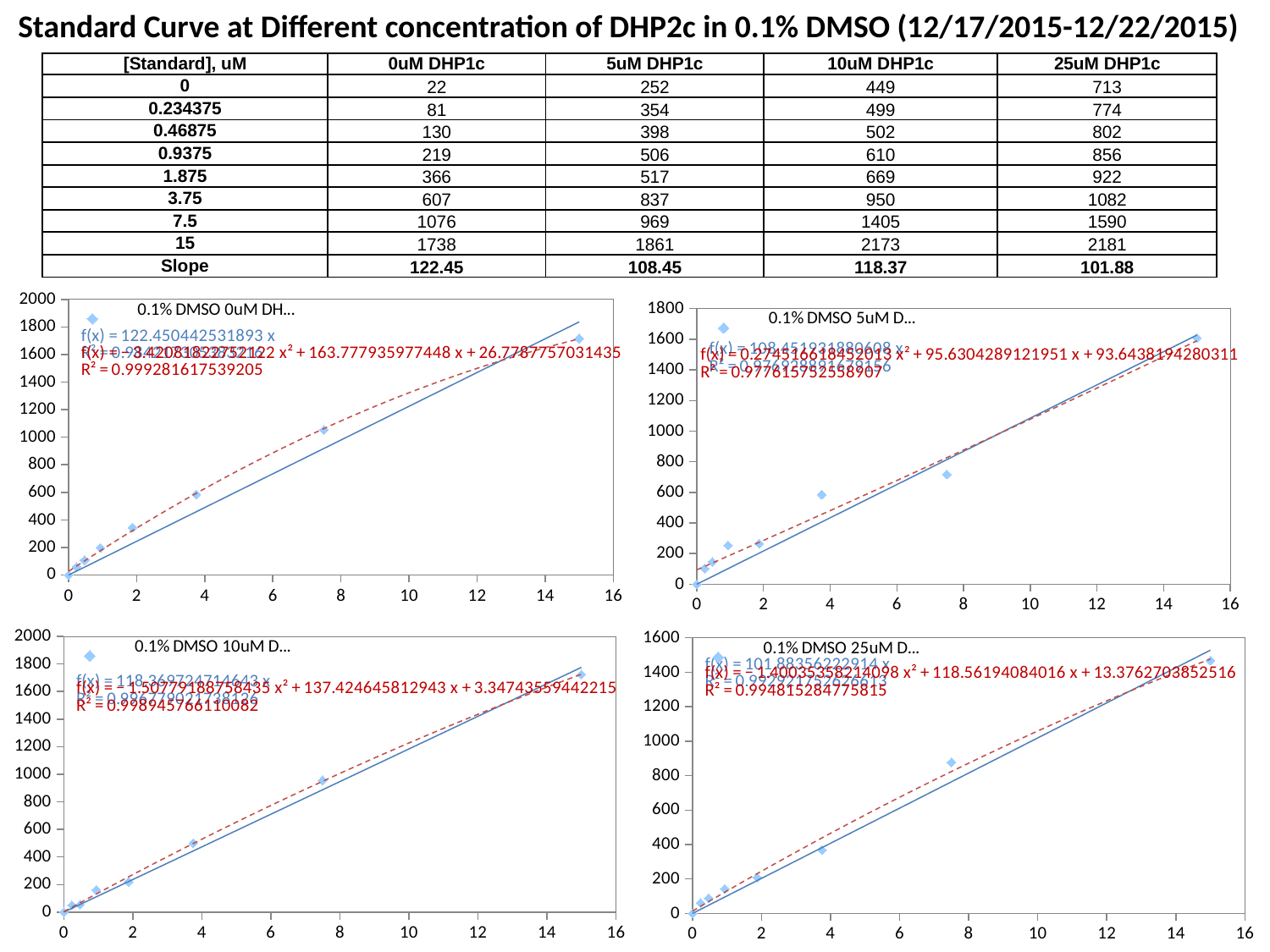
In the top-right chart (0.1% DMSO 5uM), is the value of the point at x = 15 greater or less than 1400? greater In the bottom-left chart (0.1% DMSO 10uM), is the value of the point at x = 15 greater or less than 1600? greater In the bottom-right chart (0.1% DMSO 25uM), is the value of the point at x = 15 greater or less than 1200? greater In the top-left chart (0.1% DMSO 0uM), what is the linear trendline equation shown in blue? f(x) = 122.450442531893 x What kind of chart is the top-left chart titled '0.1% DMSO 0uM DH...'? scatter chart In the top-left chart (0.1% DMSO 0uM), do the plotted values rise or fall as x increases from 0 to 15? rise In the bottom-right chart (0.1% DMSO 25uM), what is the linear trendline equation shown in blue? f(x) = 101.88356222914 x In the bottom-left chart (0.1% DMSO 10uM), do the plotted values rise or fall as x increases? rise